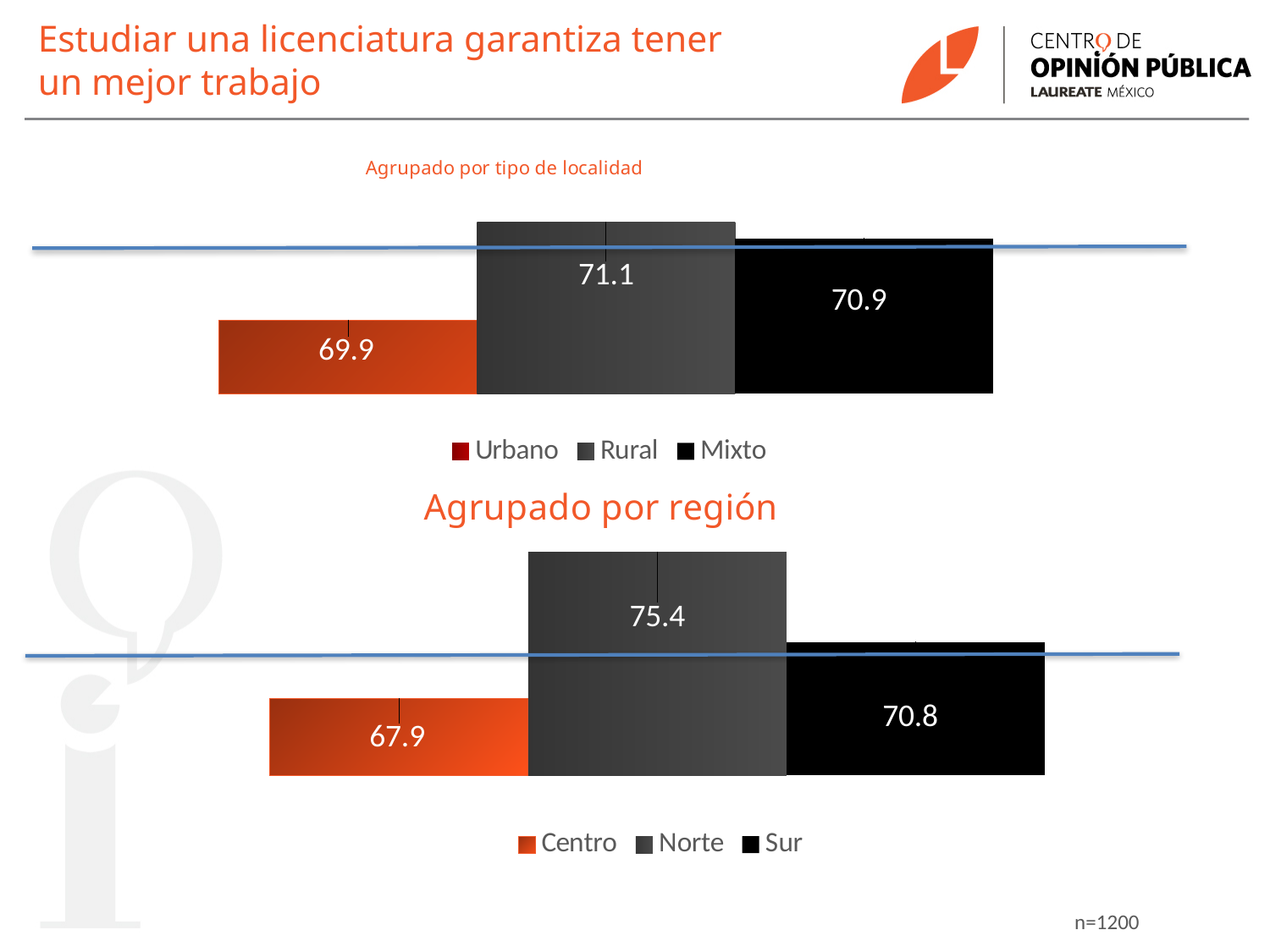
In the 'Agrupado por región' chart, what is the value for Norte? 75.4 In the 'Agrupado por región' chart, which is larger, the value for Norte or the value for Sur? Norte In the 'Agrupado por tipo de localidad' chart, what is the value for Rural? 71.1 In the 'Agrupado por tipo de localidad' chart, which series has the highest value? Rural In the 'Agrupado por región' chart, what is the value for Sur? 70.8 In the 'Agrupado por tipo de localidad' chart, which series has the lowest value? Urbano In the 'Agrupado por región' chart, which series has the lowest value? Centro In the 'Agrupado por región' chart, what is the difference between the Norte and Centro values? 7.5 How many series does the legend of the 'Agrupado por región' chart list? 3 In the 'Agrupado por tipo de localidad' chart, what is the difference between the Rural and Urbano values? 1.2 In the 'Agrupado por tipo de localidad' chart, what is the value for Urbano? 69.9 What kind of chart is the 'Agrupado por tipo de localidad' chart? Bar chart